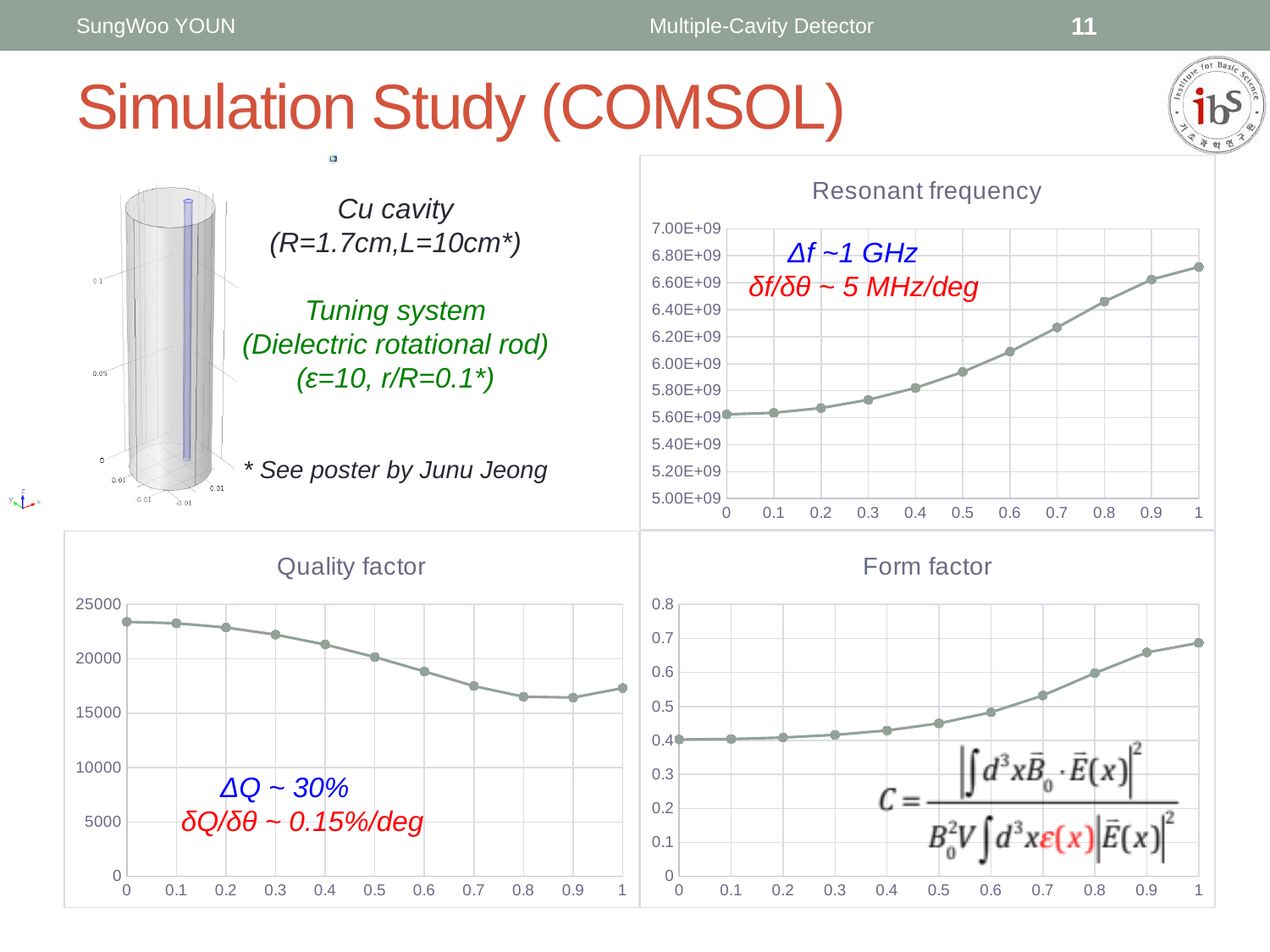
In the "Quality factor" chart, is the value at x = 0.8 greater or less than 20000? less How many data points are plotted in the "Quality factor" chart? 11 In the "Resonant frequency" chart, at which x value is the resonant frequency highest? 1 What is the title of the chart in the top-right of the slide? Resonant frequency In the "Form factor" chart, is the value at x = 0.8 greater or less than 0.5? greater In the "Resonant frequency" chart, is the value at x = 0 greater or less than 5.80E+09? less What kind of chart is the "Resonant frequency" chart? line chart In the "Quality factor" chart, do the values generally rise or fall as x increases from 0 to 1? fall In the "Form factor" chart, at which x value is the form factor highest? 1 In the "Form factor" chart, do the values rise or fall as x increases from 0 to 1? rise In the "Quality factor" chart, which is larger: the value at x = 0 or the value at x = 1? x = 0 In the "Resonant frequency" chart, do the values rise or fall as x increases from 0 to 1? rise